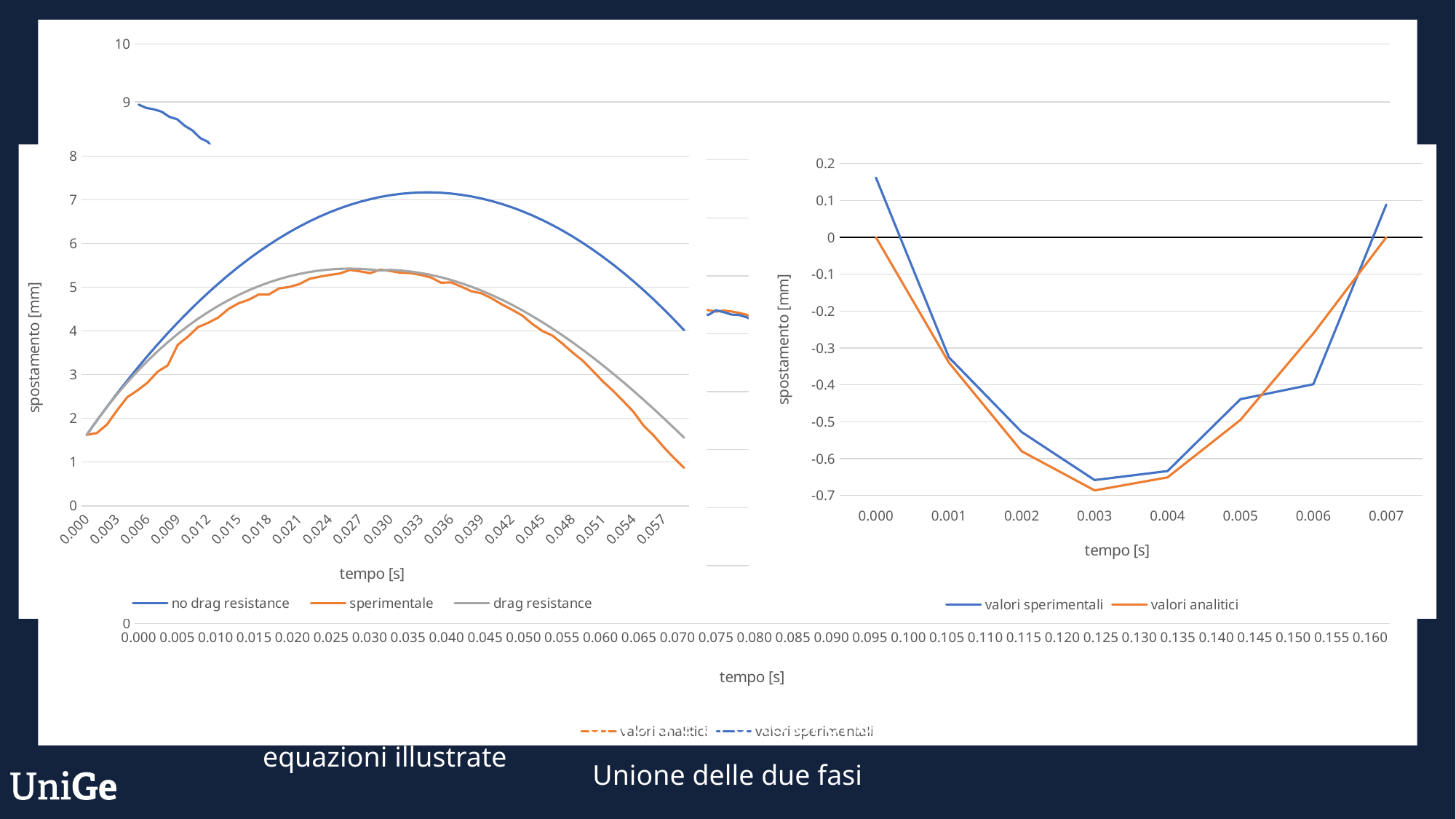
In the right chart, at tempo 0.002, which series has the larger value: 'valori sperimentali' or 'valori analitici'? valori sperimentali In the left chart, which series reaches the highest value? no drag resistance In the left chart, is the peak value of the 'drag resistance' series greater or less than 6? less How many series does the legend of the left chart list? 3 In the left chart, which series has the lowest value at the right end of the x axis? sperimentale How many series does the legend of the right chart list? 2 In the right chart, do the values of 'valori sperimentali' rise or fall from tempo 0.000 to 0.003? fall What kind of chart is the left chart on the slide? line chart In the left chart, is the peak value of the 'no drag resistance' series greater or less than 6? greater In the right chart, is the value of 'valori sperimentali' at tempo 0.000 greater or less than 0.1? greater In the right chart, at which tempo value do both series reach their lowest point? 0.003